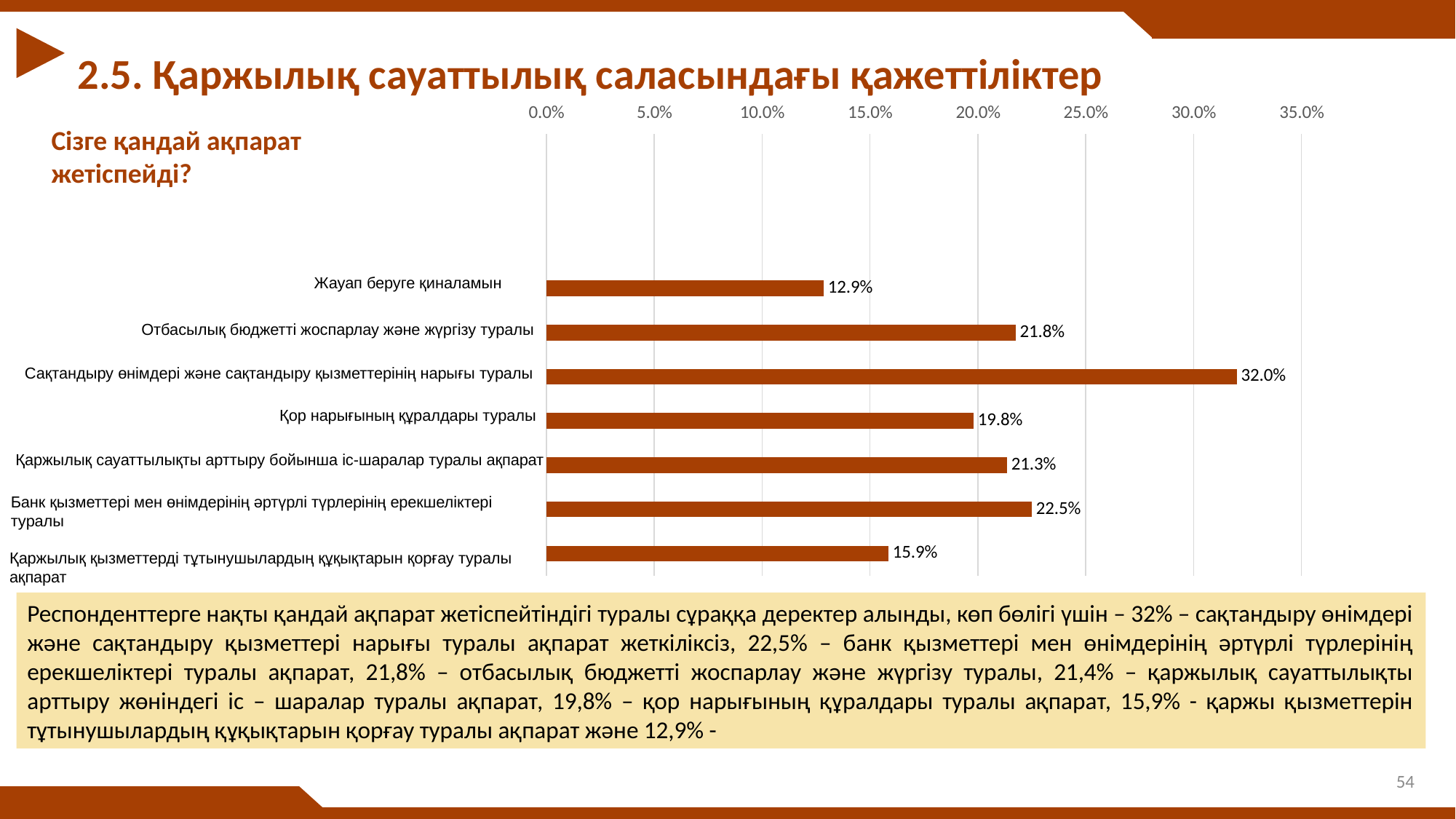
How many categories are shown in the chart? 7 Which is larger: the value for "Отбасылық бюджетті жоспарлау және жүргізу туралы" or for "Қаржылық қызметтерді тұтынушылардың құқықтарын қорғау туралы ақпарат"? Отбасылық бюджетті жоспарлау және жүргізу туралы Which category has the highest value? Сақтандыру өнімдері және сақтандыру қызметтерінің нарығы туралы What is the difference between the values for "Сақтандыру өнімдері және сақтандыру қызметтерінің нарығы туралы" and "Жауап беруге қиналамын"? 19.1 percentage points What type of chart is shown on the slide? Bar chart What is the value for "Банк қызметтері мен өнімдерінің әртүрлі түрлерінің ерекшеліктері туралы"? 22.5% What is the value for "Сақтандыру өнімдері және сақтандыру қызметтерінің нарығы туралы"? 32.0% What is the value for "Қор нарығының құралдары туралы"? 19.8% What is the value for "Жауап беруге қиналамын"? 12.9% Is the value for "Қор нарығының құралдары туралы" greater or less than 20.0%? less Which category has the lowest value? Жауап беруге қиналамын What is the value for "Қаржылық сауаттылықты арттыру бойынша іс-шаралар туралы ақпарат"? 21.3%